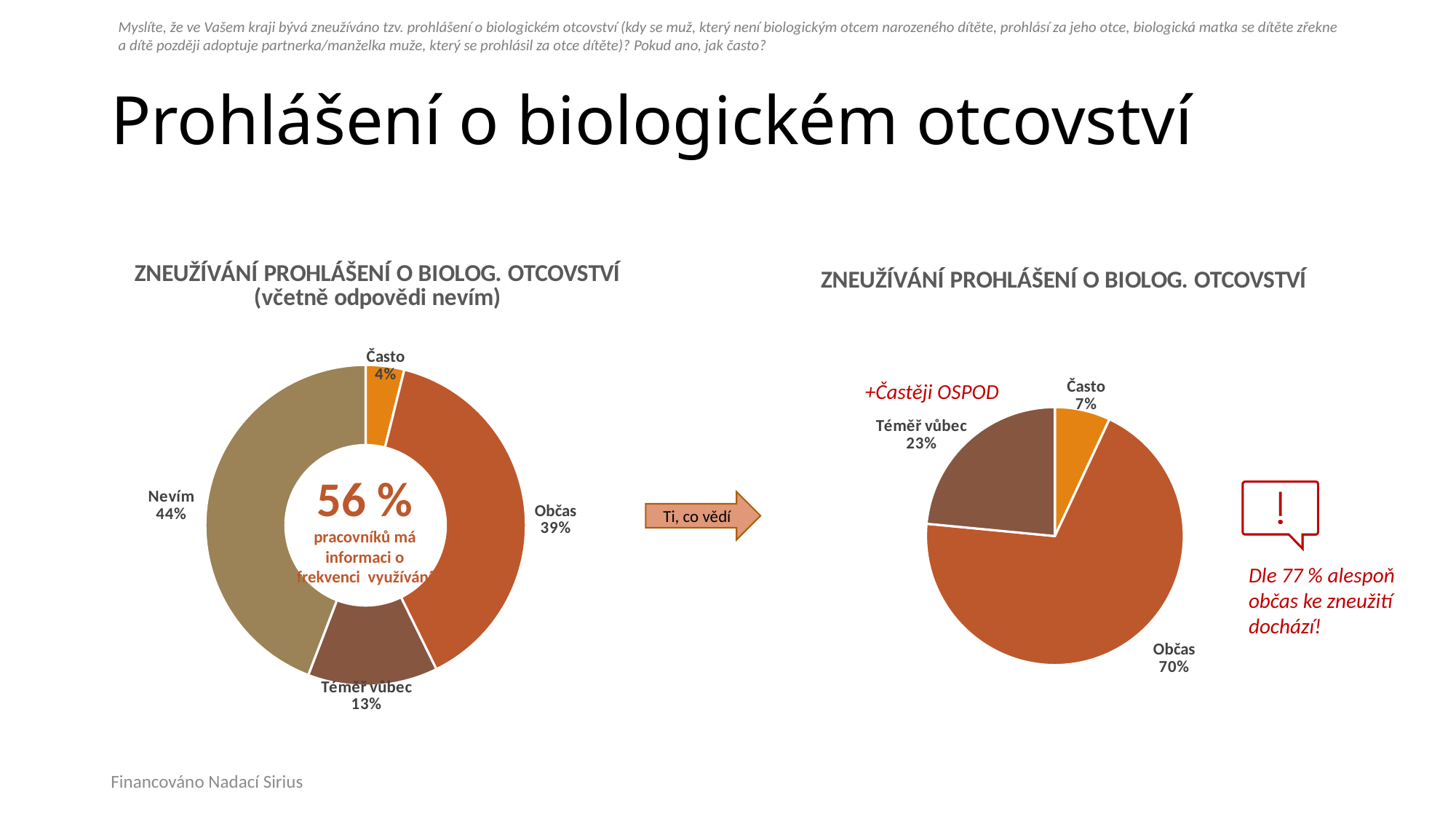
What type of chart is the right chart? Pie chart In the left chart (včetně odpovědi nevím), what is the difference between Občas and Téměř vůbec? 26 percentage points In the right chart, which category has the smallest share? Často In the right chart, how many categories are shown? 3 In the left chart (včetně odpovědi nevím), which category has the largest share? Nevím In the right chart, what is the share for Občas? 70% In the left chart (včetně odpovědi nevím), what is the share for Nevím? 44% In the left chart (včetně odpovědi nevím), what is the share for Často? 4% In the left chart (včetně odpovědi nevím), which category has the smallest share? Často In the right chart, which is larger, Často or Téměř vůbec? Téměř vůbec In the left chart (včetně odpovědi nevím), how many categories are shown? 4 In the right chart, what is the share for Téměř vůbec? 23%